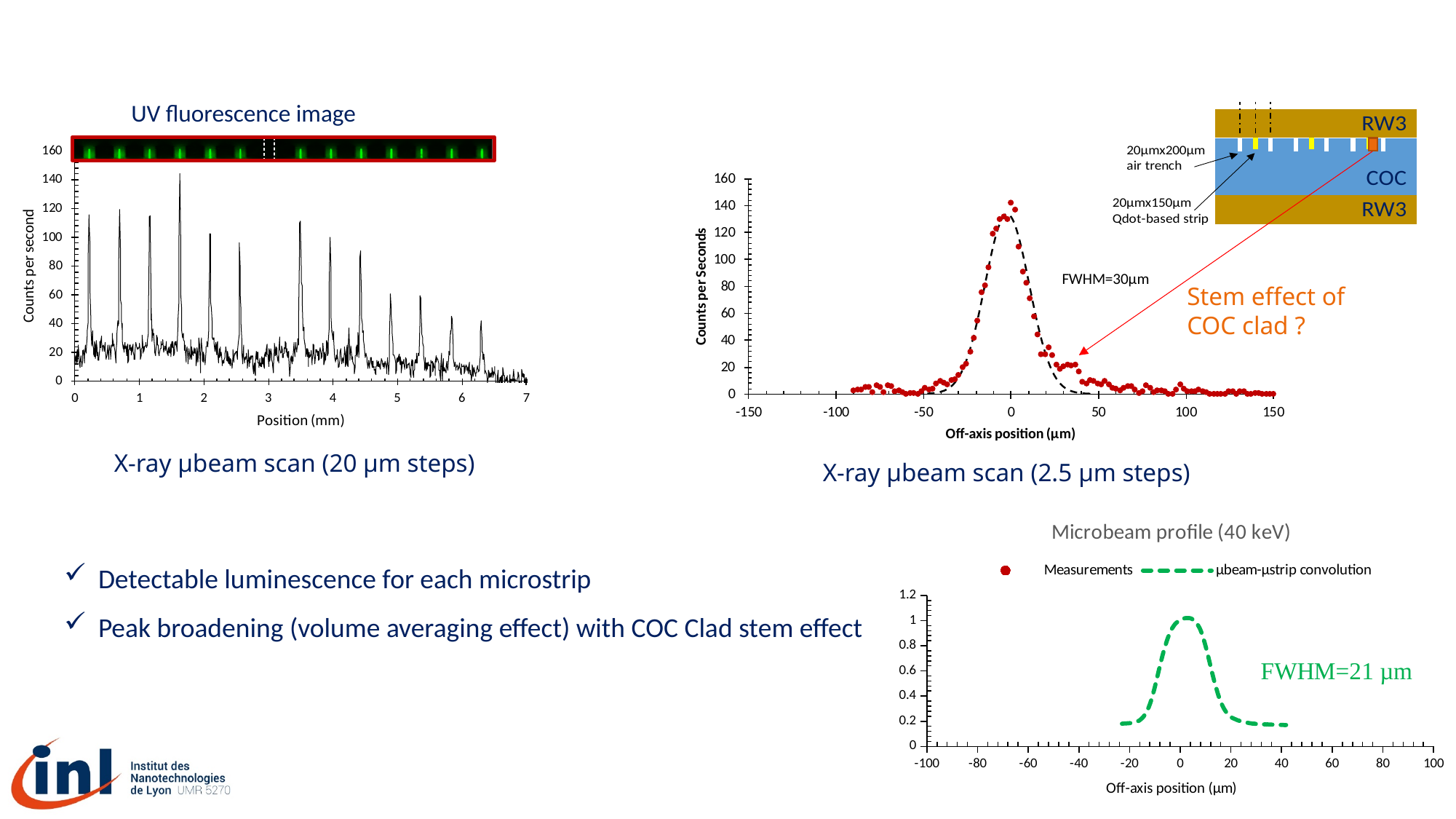
On the 'Microbeam profile (40 keV)' chart, is the peak of the dashed convolution curve greater or less than 0.8? greater On the 'X-ray µbeam scan (20 µm steps)' chart on the left, is the tallest peak greater or less than 120 counts per second? greater On the 'Microbeam profile (40 keV)' chart, what FWHM value is annotated? FWHM=21 µm On the 'X-ray µbeam scan (20 µm steps)' chart on the left, what is the label of the x axis? Position (mm) On the 'X-ray µbeam scan (2.5 µm steps)' chart on the upper right, what FWHM value is annotated? FWHM=30µm How many series does the legend of the 'Microbeam profile (40 keV)' chart list? 2 On the 'X-ray µbeam scan (2.5 µm steps)' chart on the upper right, what are the minimum and maximum values shown on the x axis? -150 and 150 On the 'X-ray µbeam scan (20 µm steps)' chart on the left, what is the maximum value shown on the x axis? 7 What kind of chart is the 'X-ray µbeam scan (20 µm steps)' chart on the left? line chart On the 'X-ray µbeam scan (2.5 µm steps)' chart on the upper right, what is the label of the x axis? Off-axis position (µm) On the 'X-ray µbeam scan (2.5 µm steps)' chart on the upper right, is the peak of the measured data greater or less than 120 counts per second? greater On the 'X-ray µbeam scan (20 µm steps)' chart on the left, what is the label of the y axis? Counts per second